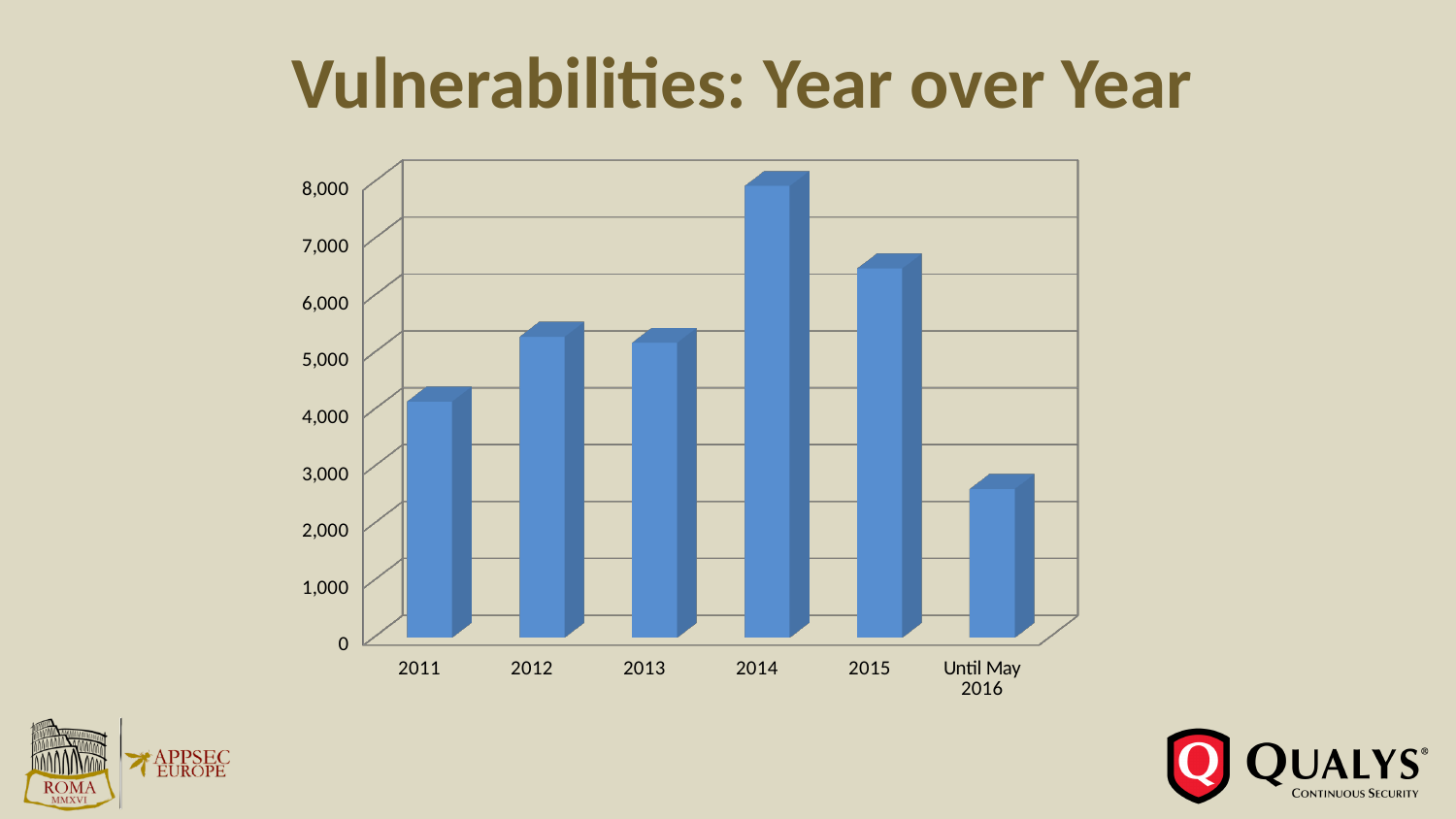
Which is larger, the value for 2011 or the value for 2012? 2012 Do the values rise or fall from 2014 to Until May 2016? fall What kind of chart is shown on the slide? bar chart How many categories are shown on the x axis? 6 Is the value for 2014 greater or less than 7,000? greater Is the value for Until May 2016 greater or less than 3,000? less Which category has the highest value? 2014 What is the title of the chart? Vulnerabilities: Year over Year Is the value for 2011 greater or less than 5,000? less Which is larger, the value for 2014 or the value for 2015? 2014 Which category has the lowest value? Until May 2016